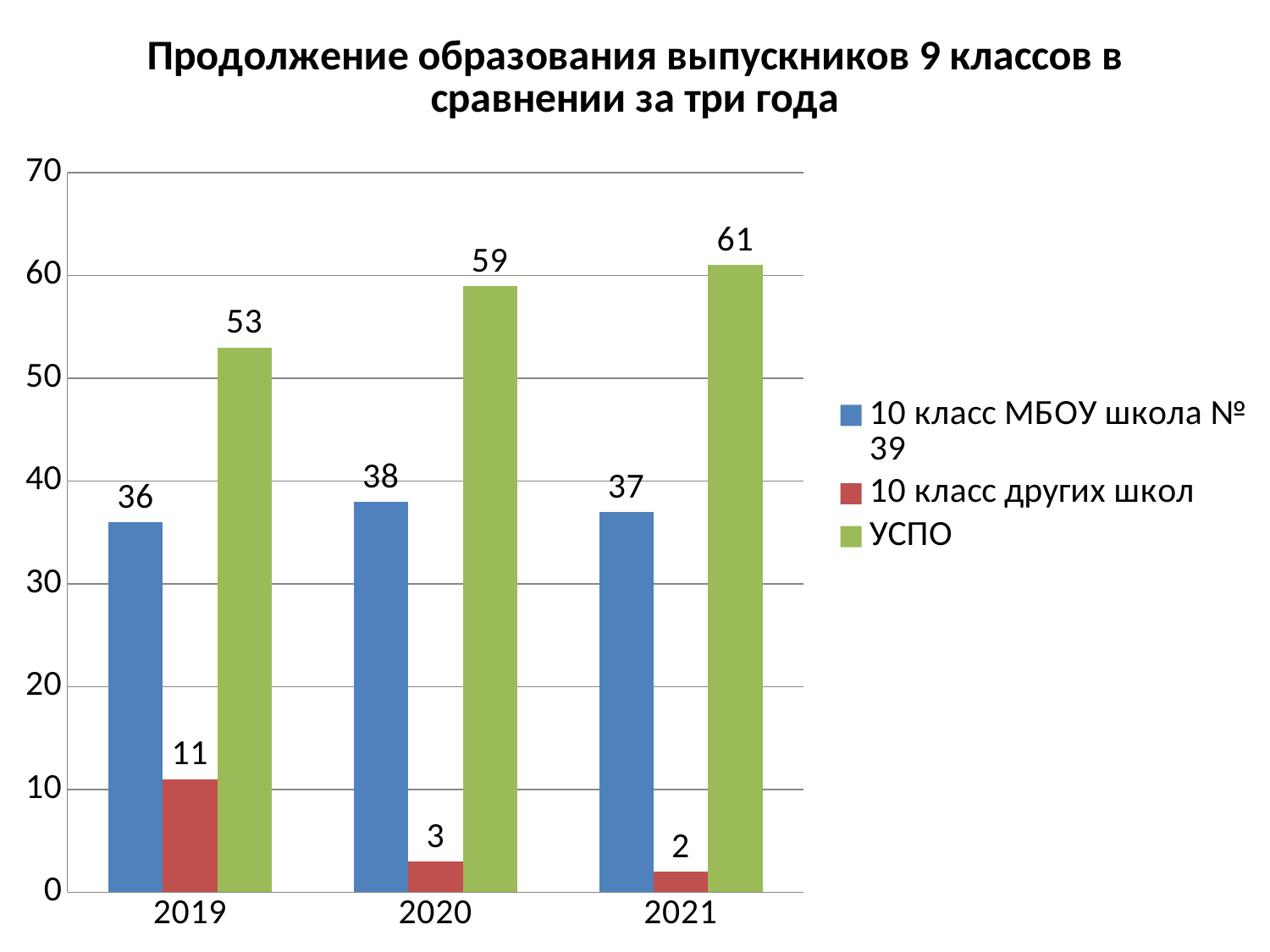
Which is larger in 2020: 10 класс МБОУ школа № 39 or УСПО? УСПО What colour are the bars for УСПО? green What is the difference between the УСПО value in 2021 and in 2019? 8 Does the value for УСПО rise or fall from 2019 to 2021? rise In which year is the value for 10 класс других школ lowest? 2021 How many years are shown on the x axis? 3 What is the value for 10 класс МБОУ школа № 39 in 2021? 37 What is the value for УСПО in 2020? 59 How many series does the legend list? 3 What kind of chart is shown on the slide? bar chart In which year is the value for УСПО highest? 2021 What is the value for 10 класс других школ in 2019? 11